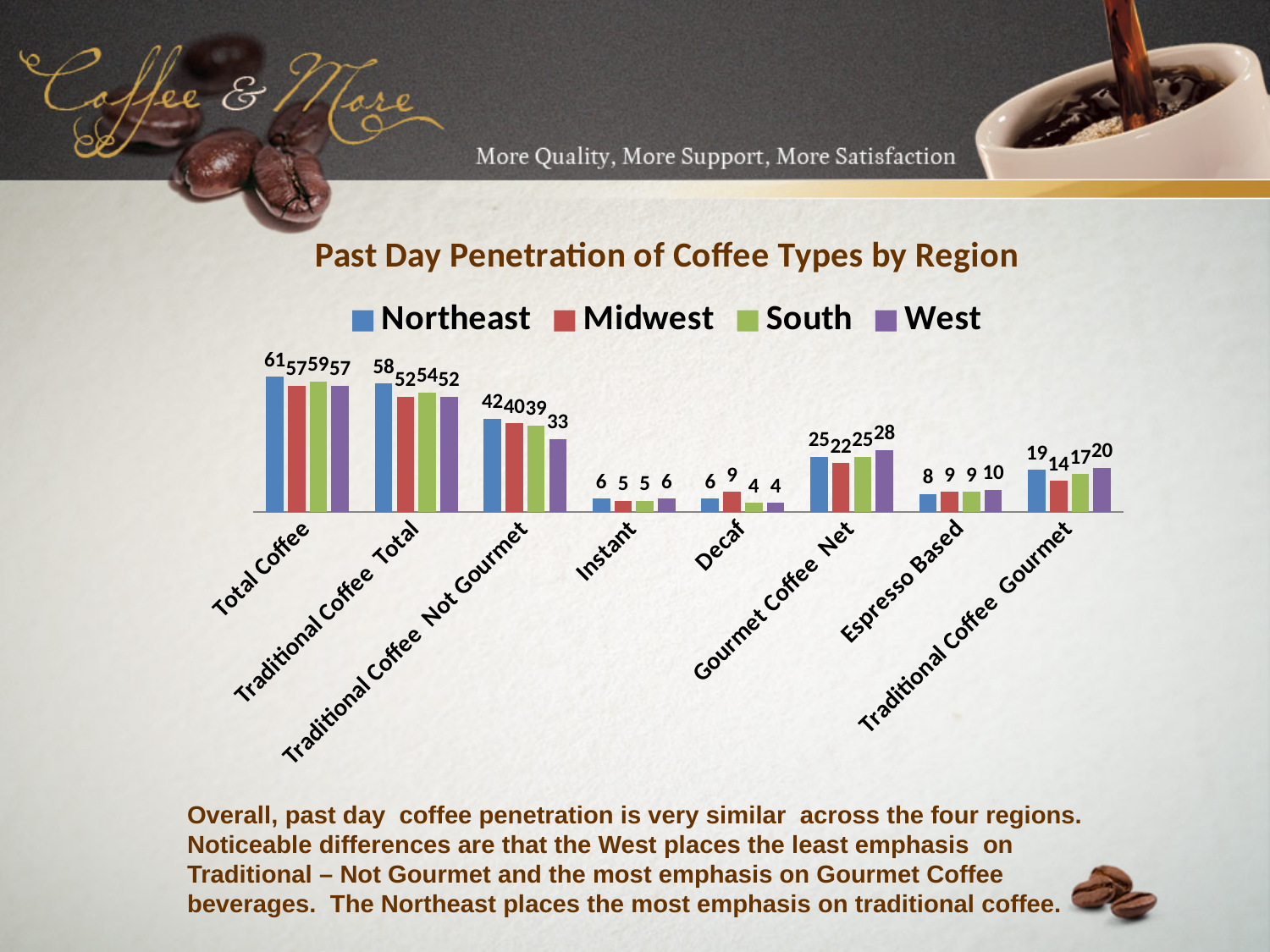
What is the difference between the Northeast and West values for Traditional Coffee Not Gourmet? 9 How many coffee type categories are shown on the x axis? 8 What is the West value for Traditional Coffee Not Gourmet? 33 How many series does the legend list? 4 What is the Midwest value for Decaf? 9 What is the South value for Gourmet Coffee Net? 25 Which region has the highest value for Gourmet Coffee Net? West What is the title of the chart? Past Day Penetration of Coffee Types by Region What is the Northeast value for Total Coffee? 61 Which is larger for Traditional Coffee Total: the Northeast value or the South value? Northeast What kind of chart is shown on the slide? Bar chart Which region has the lowest value for Traditional Coffee Gourmet? Midwest